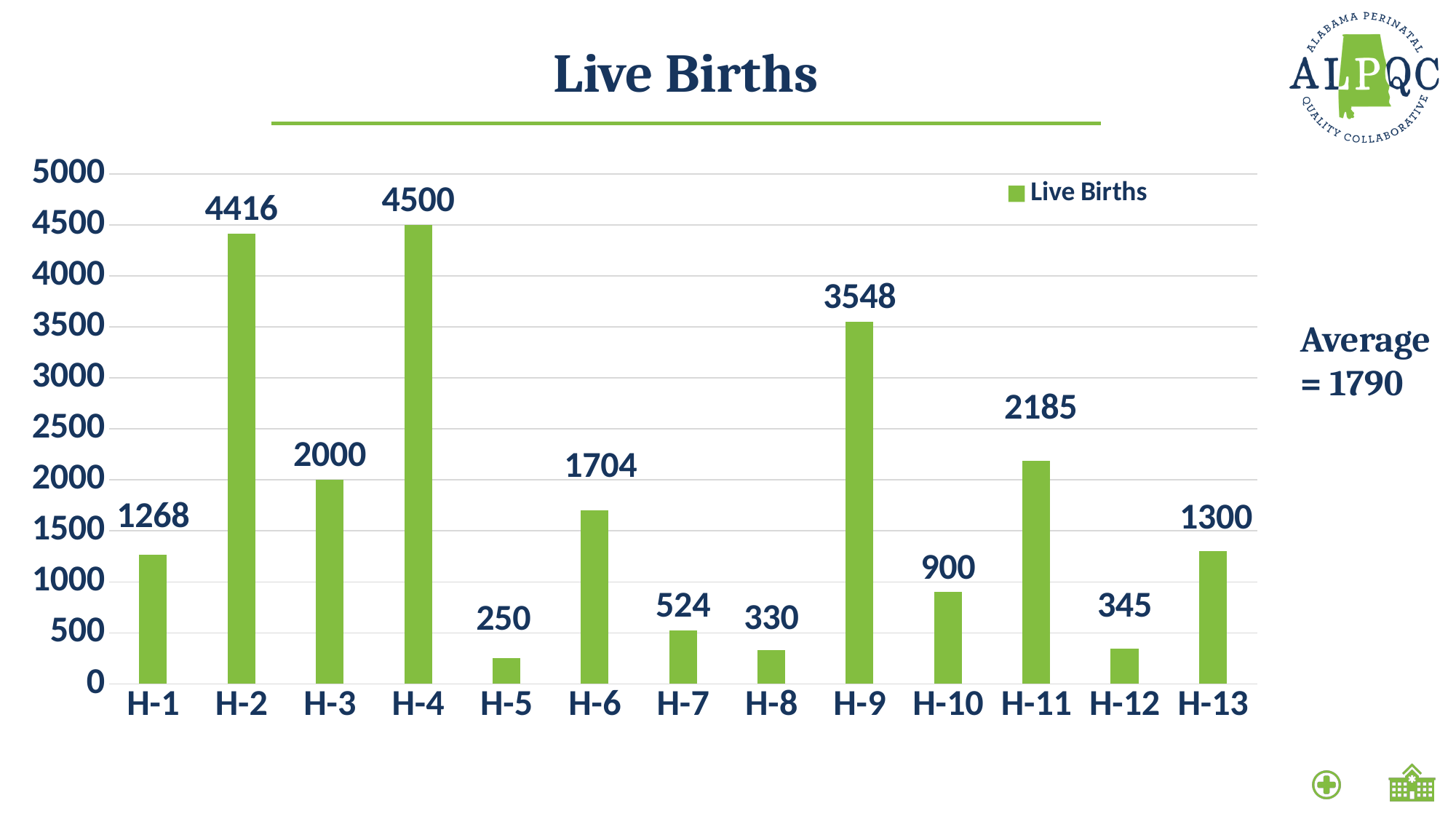
Which is larger, the value for H-1 or the value for H-13? H-13 Which category has the highest value? H-4 What is the difference between the values for H-11 and H-10? 1285 Is the value for H-3 greater or less than 1500? greater What kind of chart is shown? bar chart What is the title of the chart? Live Births What is the difference between the values for H-4 and H-2? 84 What is the value for H-6? 1704 What is the value for H-9? 3548 What is the value for H-12? 345 How many categories are shown on the x axis? 13 Which category has the lowest value? H-5